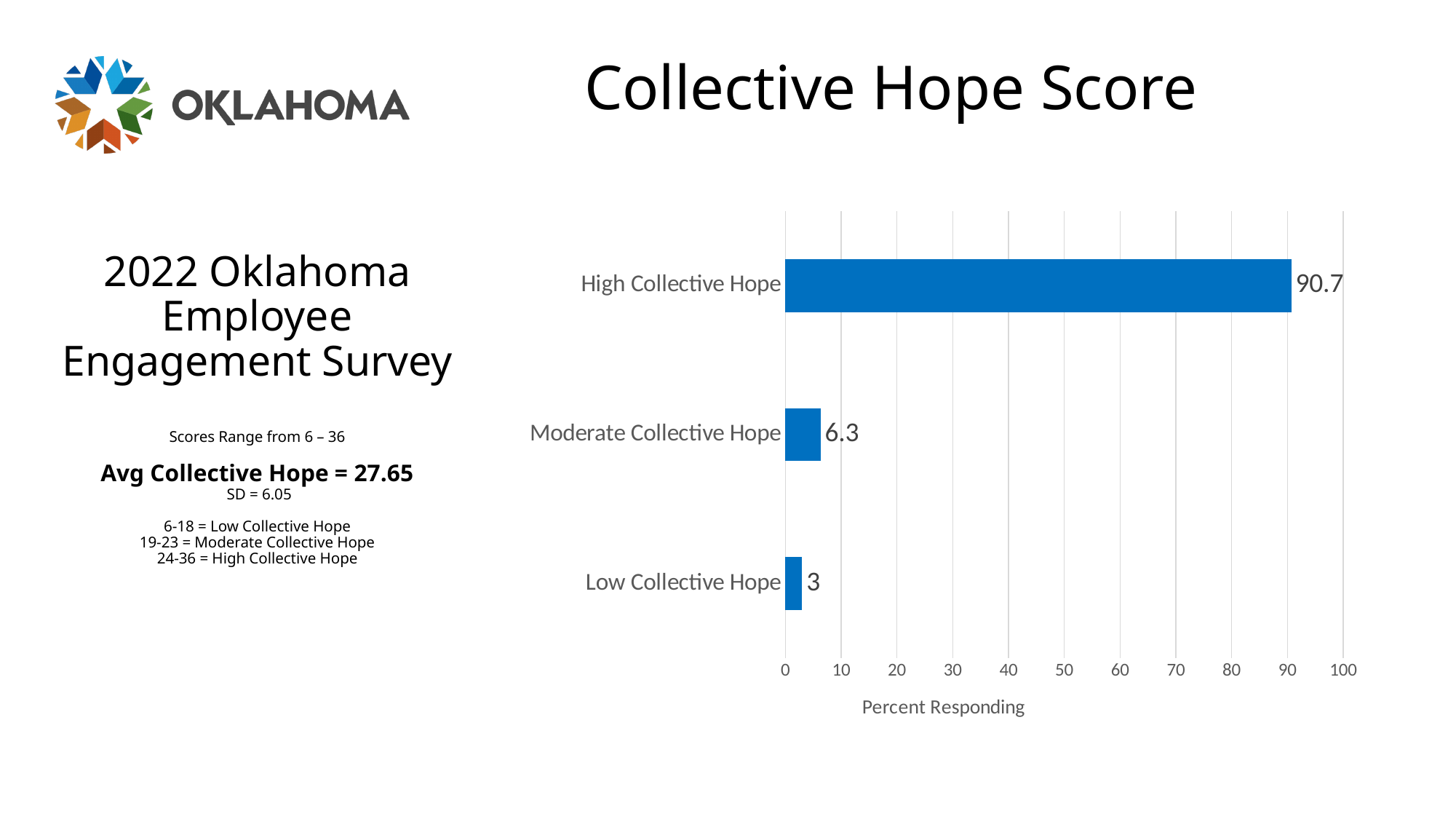
Which is larger, the value for Moderate Collective Hope or Low Collective Hope? Moderate Collective Hope What is the difference between the values for High Collective Hope and Moderate Collective Hope? 84.4 How many categories are shown in the chart? 3 What is the label of the horizontal axis? Percent Responding What is the value for Moderate Collective Hope? 6.3 Which category has the lowest value? Low Collective Hope Which category has the highest value? High Collective Hope What is the difference between the values for Moderate Collective Hope and Low Collective Hope? 3.3 Is the value for High Collective Hope greater or less than 80? greater What kind of chart is shown on the slide? bar chart What is the value for High Collective Hope? 90.7 What is the value for Low Collective Hope? 3